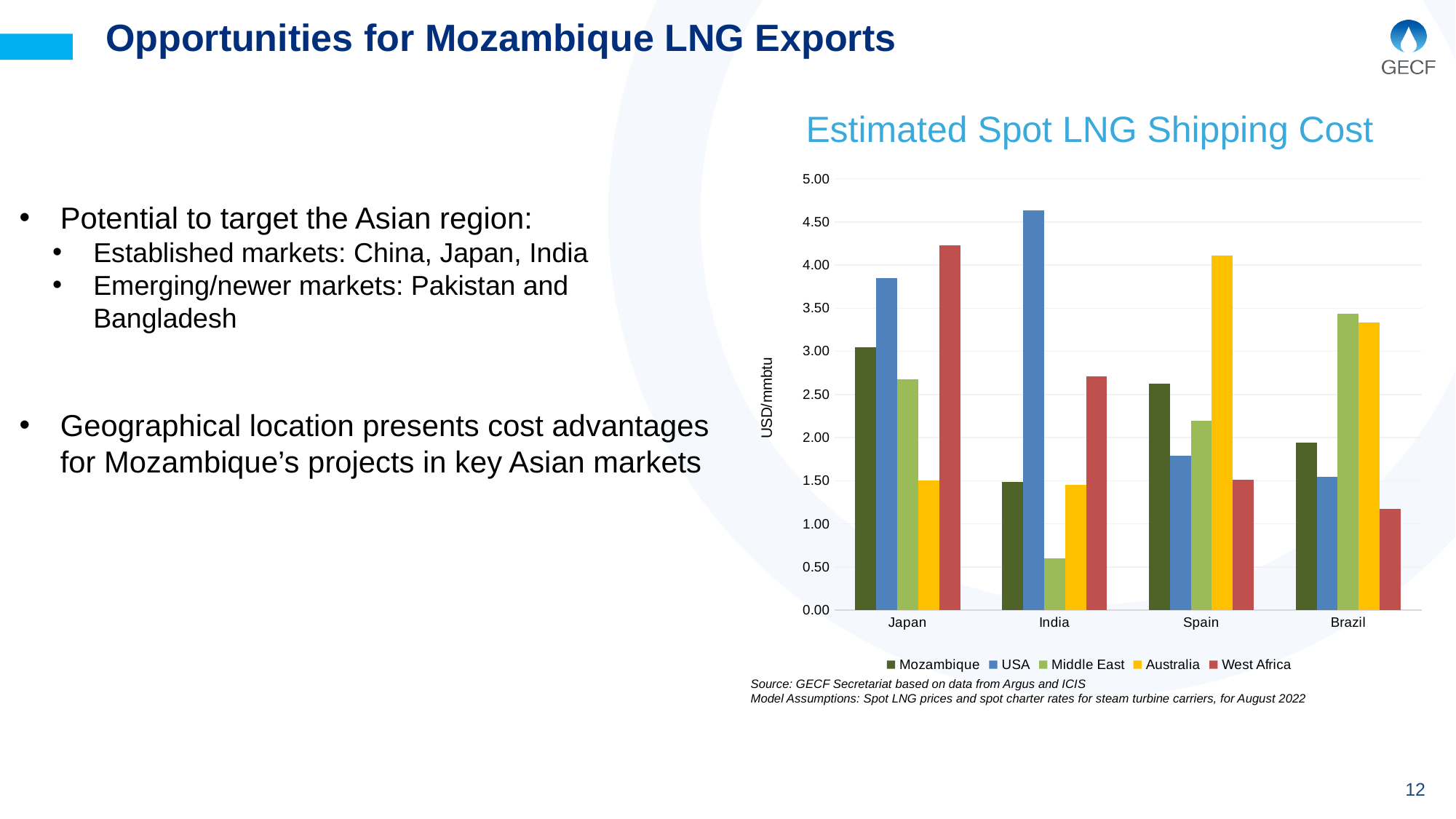
For India, which supplier has the highest estimated spot LNG shipping cost? USA How many series does the chart legend list? 5 For Spain, which supplier has the highest estimated spot LNG shipping cost? Australia Is the value for Middle East to India greater or less than 1.00? less Is the value for Mozambique to Spain greater or less than 2.50? greater Is the value for USA to India greater or less than 4.50? greater What kind of chart is shown on the slide? bar chart For Brazil, which supplier has the lowest estimated spot LNG shipping cost? West Africa For India, which supplier has the lowest estimated spot LNG shipping cost? Middle East For Japan, which is larger: the shipping cost from West Africa or from USA? West Africa How many destination categories are shown on the x axis of the chart? 4 What unit is shown on the y axis of the chart? USD/mmbtu